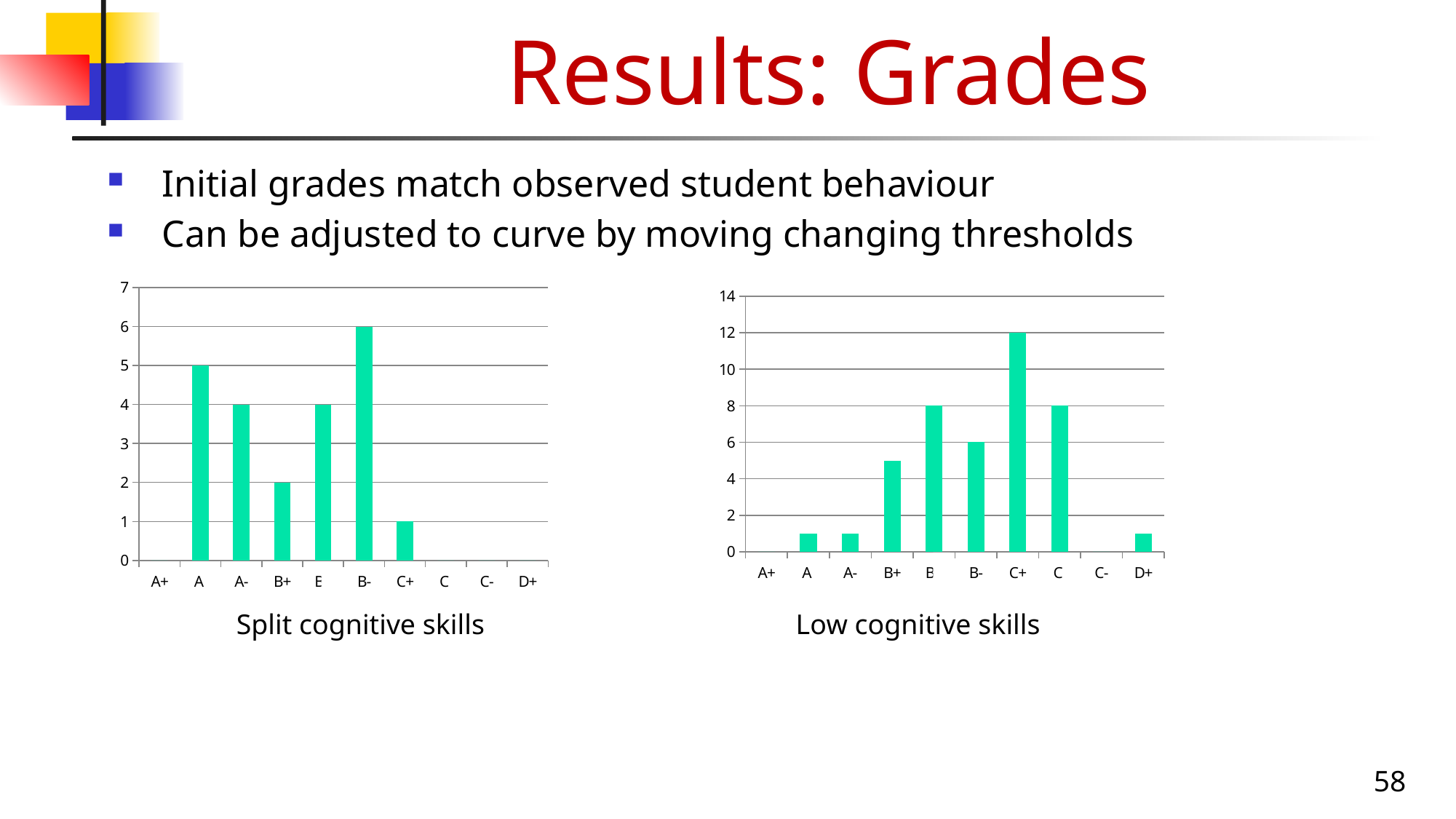
What kind of chart is the 'Split cognitive skills' chart? bar chart In the 'Low cognitive skills' chart, which is larger, the value for B or the value for B-? B In the 'Low cognitive skills' chart, is the value for B+ greater or less than 4? greater In the 'Split cognitive skills' chart, what is the difference between the values for B- and B+? 4 In the 'Low cognitive skills' chart, what is the value for grade B-? 6 In the 'Split cognitive skills' chart, what is the value for grade B-? 6 How many grade categories are shown on the x axis of the 'Split cognitive skills' chart? 10 In the 'Split cognitive skills' chart, which is larger, the value for A or the value for A-? A In the 'Low cognitive skills' chart, what is the value for grade C+? 12 In the 'Low cognitive skills' chart, which grade has the highest bar? C+ In the 'Split cognitive skills' chart, what is the value for grade A? 5 In the 'Split cognitive skills' chart, which grade has the highest bar? B-